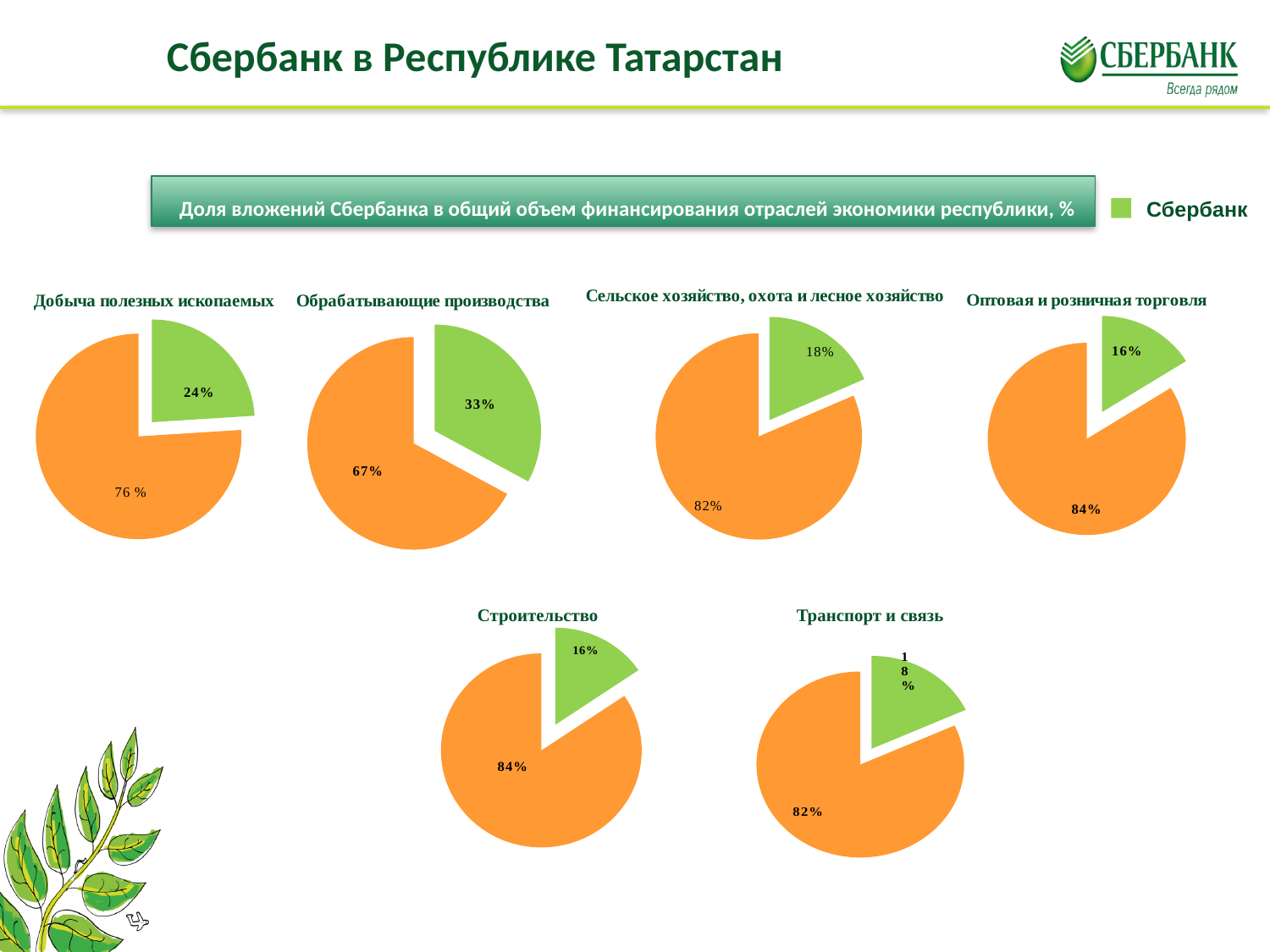
In the 'Сельское хозяйство, охота и лесное хозяйство' pie chart, what share does the orange slice have? 82% In the 'Оптовая и розничная торговля' pie chart, what share does the green (Сбербанк) slice have? 16% What is the difference between the green slice in the 'Обрабатывающие производства' chart and the green slice in the 'Оптовая и розничная торговля' chart? 17% In the 'Строительство' pie chart, what share does the orange slice have? 84% What type of chart is used for 'Строительство'? Pie chart Which is larger: the green slice in the 'Добыча полезных ископаемых' chart or the green slice in the 'Сельское хозяйство, охота и лесное хозяйство' chart? Добыча полезных ископаемых In the 'Добыча полезных ископаемых' pie chart, what share does the green (Сбербанк) slice have? 24% Across all the pie charts on the slide, which industry has the largest green (Сбербанк) share? Обрабатывающие производства In the 'Обрабатывающие производства' pie chart, what share does the green (Сбербанк) slice have? 33% In the 'Транспорт и связь' pie chart, what share does the orange slice have? 82% How many pie charts are shown on the slide? 6 What does the green colour in the legend represent? Сбербанк